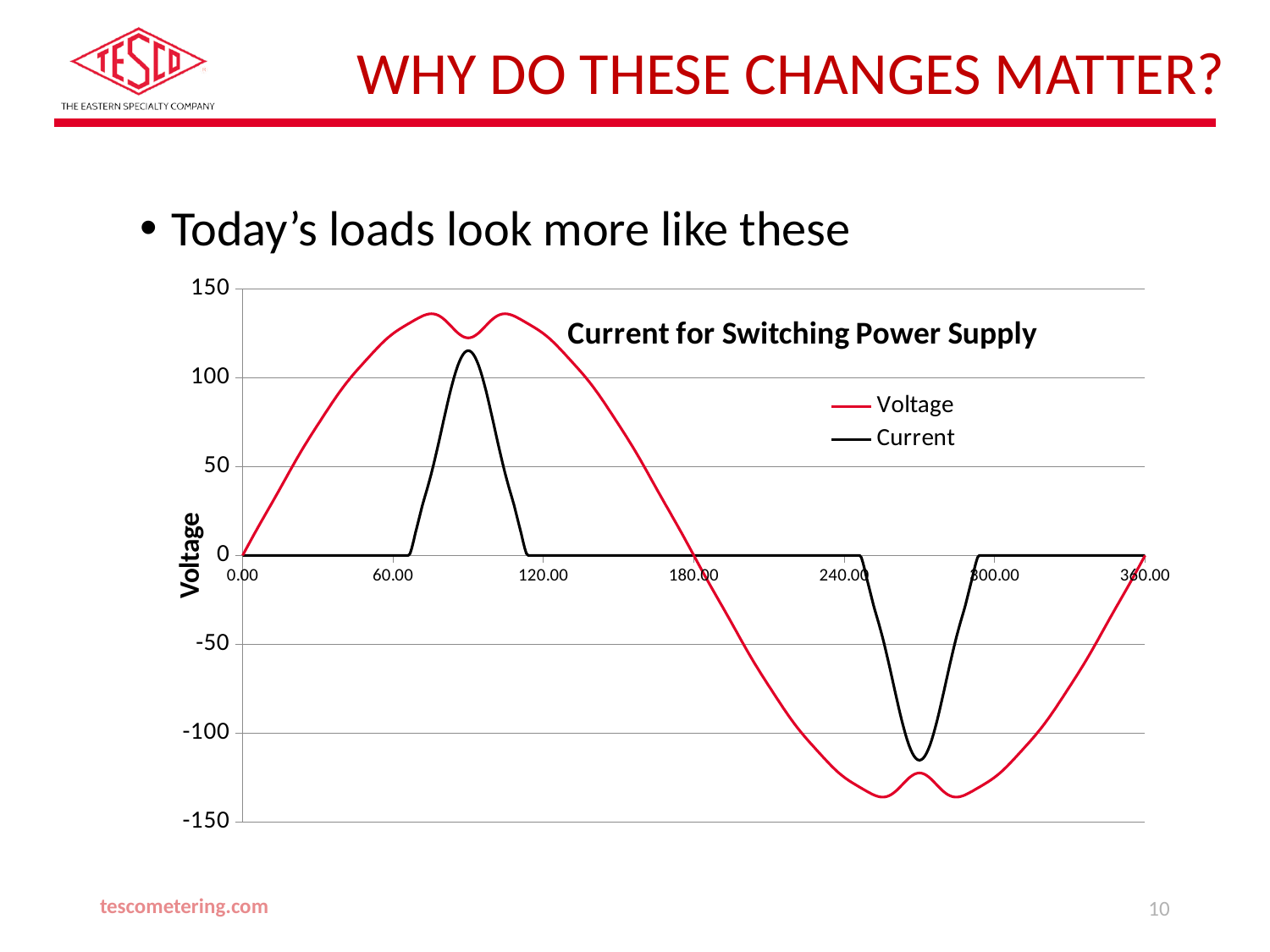
What is the Voltage value at 180.00 on the x axis? 0 Is the peak value of the Voltage series greater or less than 100? greater What is the Current value at 60.00 on the x axis? 0 How many series does the legend list? 2 Is the lowest value of the Voltage series greater or less than -100? less How many labelled tick marks are on the x axis? 7 What kind of chart is shown on the slide? line chart What is the title of the chart? Current for Switching Power Supply Which colour is used for the Current series? black Which series reaches the higher peak value, Voltage or Current? Voltage Is the peak value of the Current series greater or less than 50? greater Does the Voltage series rise or fall between 120.00 and 180.00 on the x axis? fall